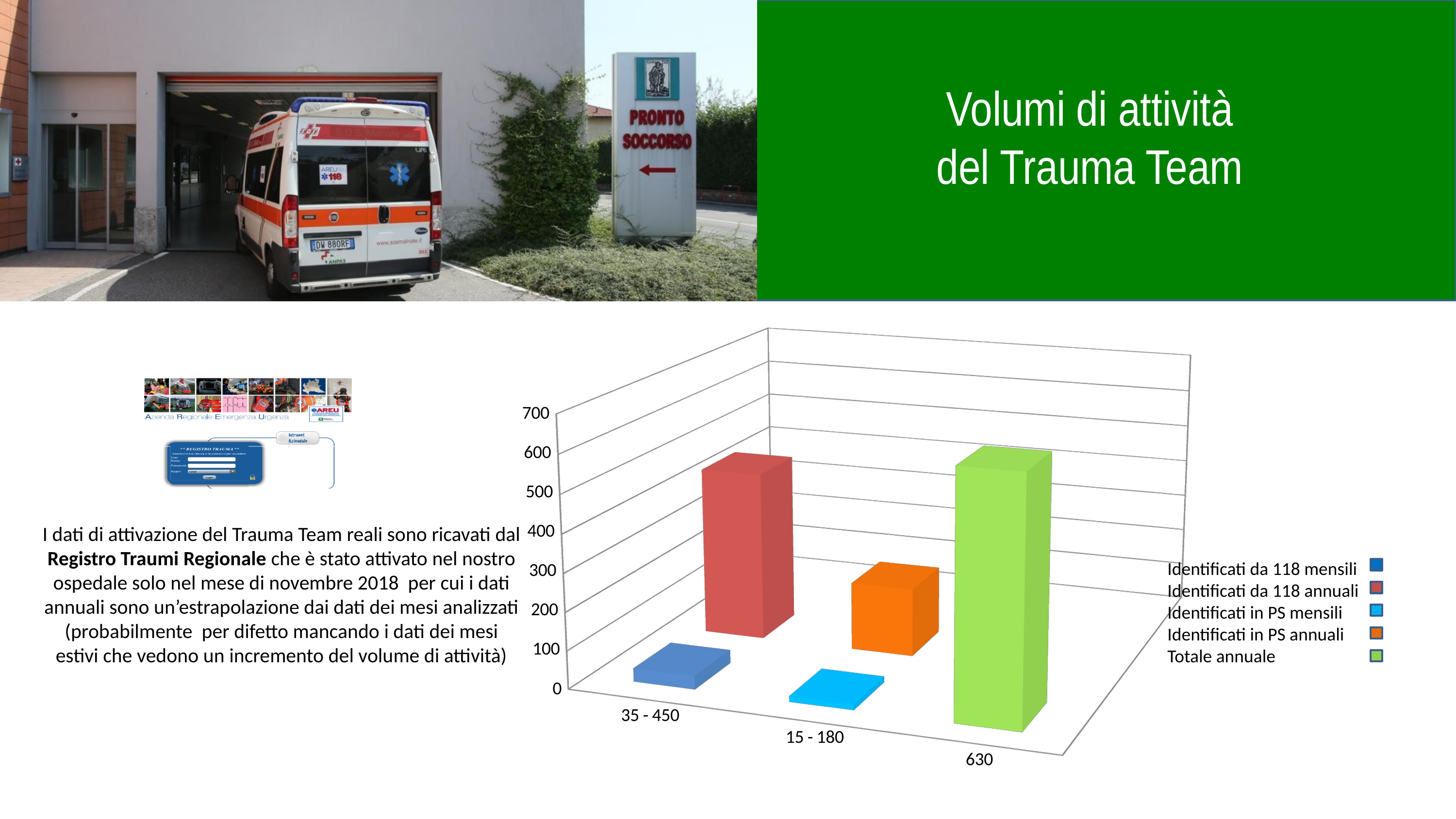
Is the value for Identificati in PS mensili greater or less than 100? less How many bars are plotted in the chart? 5 What kind of chart is shown on the slide? bar chart Which series has the tallest bar in the chart? Totale annuale Is the value for Identificati da 118 annuali greater or less than 300? greater Is the value for Totale annuale greater or less than 500? greater Which series has the shortest bar in the chart? Identificati in PS mensili How many series does the chart legend list? 5 What colour is used for the Totale annuale series in the legend? green Which bar is taller: Identificati da 118 annuali or Identificati in PS annuali? Identificati da 118 annuali What is the x-axis label printed under the green Totale annuale bar? 630 Which bar is taller: Identificati da 118 mensili or Identificati in PS mensili? Identificati da 118 mensili